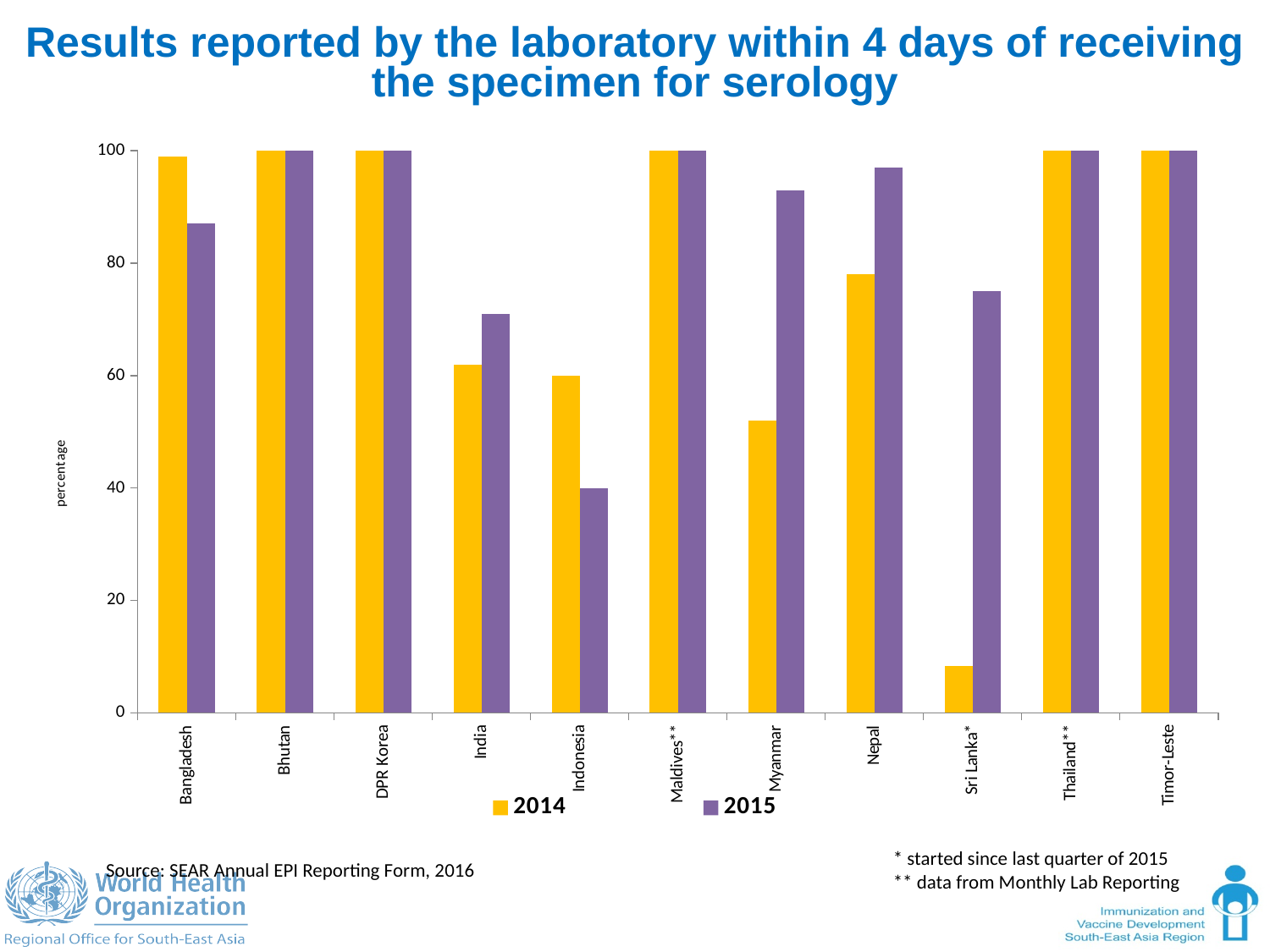
What kind of chart is shown on the slide? bar chart How many countries are shown on the x axis? 11 What is the 2014 value for Thailand**? 100 For Bangladesh, which is larger, the 2014 value or the 2015 value? 2014 Is the 2014 value for Sri Lanka* greater or less than 20? less Which country has the lowest 2015 value? Indonesia For Myanmar, which is larger, the 2014 value or the 2015 value? 2015 Is the 2015 value for Nepal greater or less than 80? greater Which country has the lowest 2014 value? Sri Lanka* How many series does the legend list? 2 What is the 2015 value for Bhutan? 100 What is the label of the y axis? percentage